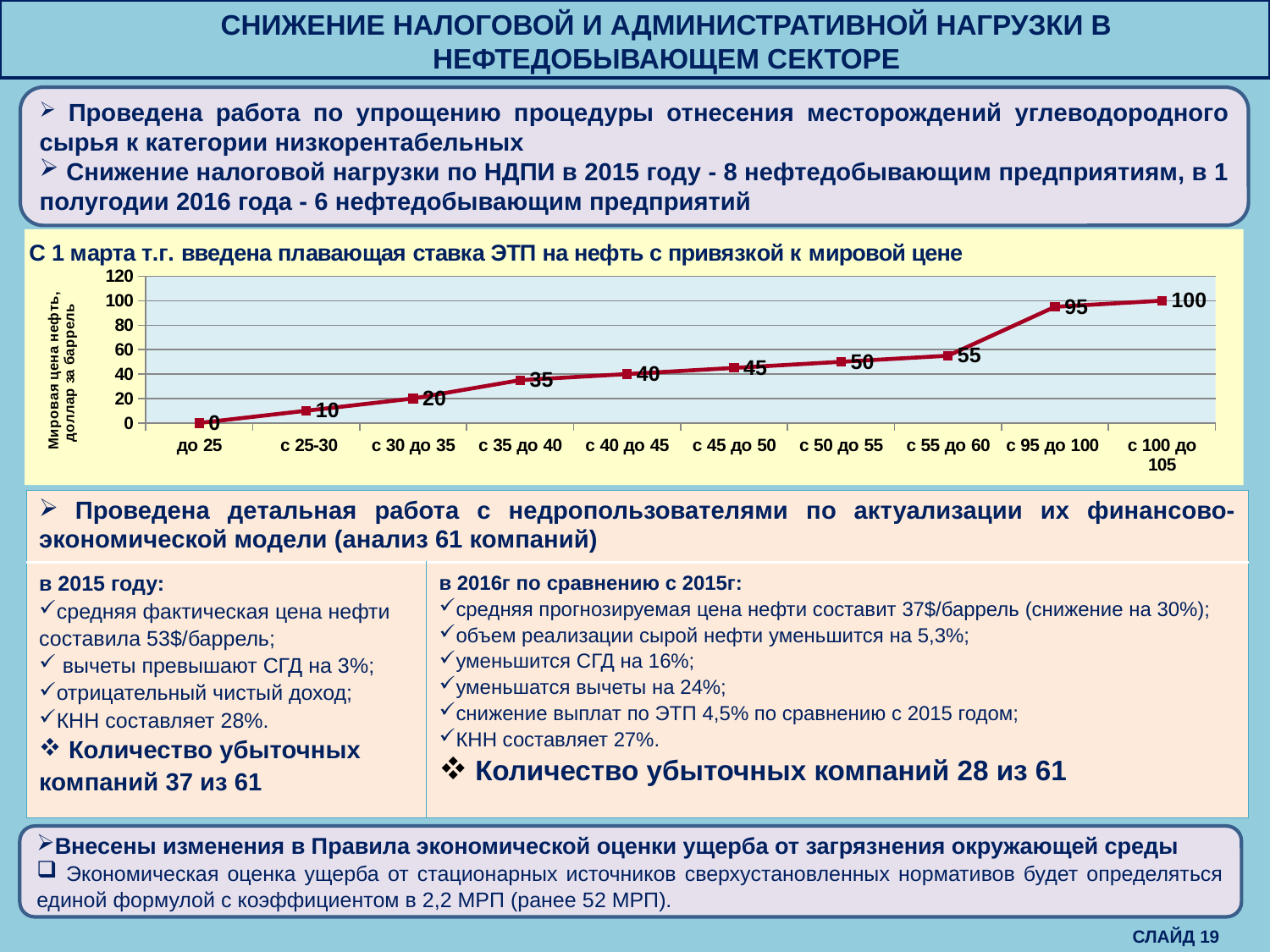
What is the value for the category "с 55 до 60"? 55 Which category has the highest value? с 100 до 105 What type of chart is shown on the slide? line chart What is the label of the vertical axis of the chart? Мировая цена нефть, доллар за баррель What is the value for the category "с 35 до 40"? 35 Which is larger, the value for "с 30 до 35" or the value for "с 45 до 50"? с 45 до 50 What is the difference between the values for "с 95 до 100" and "с 55 до 60"? 40 What is the value for the category "до 25"? 0 How many categories are plotted along the x axis of the chart? 10 What is the value for the category "с 95 до 100"? 95 Do the values rise or fall along the x axis from "до 25" to "с 100 до 105"? rise Which category has the lowest value? до 25